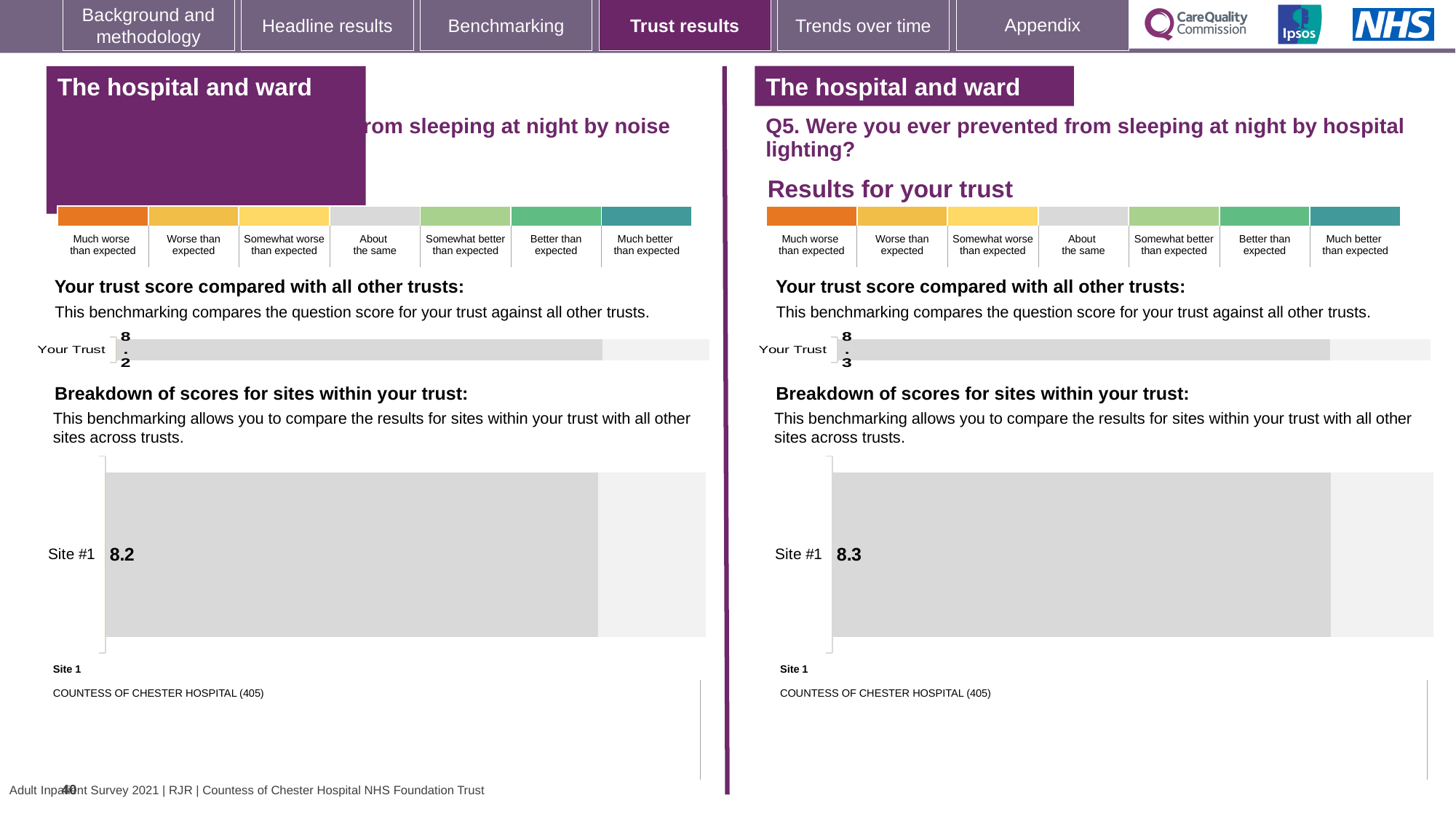
How many sites are plotted in the 'Breakdown of scores for sites within your trust' chart on the left-hand side of the slide (noise)? 1 On the right-hand side of the slide (Q5, hospital lighting), what is the score shown for Your Trust in the 'Your trust score compared with all other trusts' chart? 8.3 How many sites are plotted in the 'Breakdown of scores for sites within your trust' chart on the right-hand side of the slide (Q5, hospital lighting)? 1 On the right-hand side of the slide (Q5, hospital lighting), what score is shown for Site #1 in the 'Breakdown of scores for sites within your trust' chart? 8.3 Which is larger: the Your Trust score on the left-hand chart (noise) or the Your Trust score on the right-hand chart (Q5, hospital lighting)? Right-hand chart (Q5, hospital lighting) What is the full question text shown above the charts on the right-hand side of the slide? Q5. Were you ever prevented from sleeping at night by hospital lighting? What kind of chart is used to show the Site #1 score in the 'Breakdown of scores for sites within your trust' section on the right-hand side of the slide? Bar chart On the left-hand side of the slide (the question about noise), what score is shown for Site #1 in the 'Breakdown of scores for sites within your trust' chart? 8.2 What is the difference between the Site #1 score on the right-hand chart (Q5, hospital lighting) and the Site #1 score on the left-hand chart (noise)? 0.1 Which site is listed as Site 1 beneath the 'Breakdown of scores for sites within your trust' chart on the right-hand side of the slide? COUNTESS OF CHESTER HOSPITAL (405) On the left-hand side of the slide (the question about noise), what is the score shown for Your Trust in the 'Your trust score compared with all other trusts' chart? 8.2